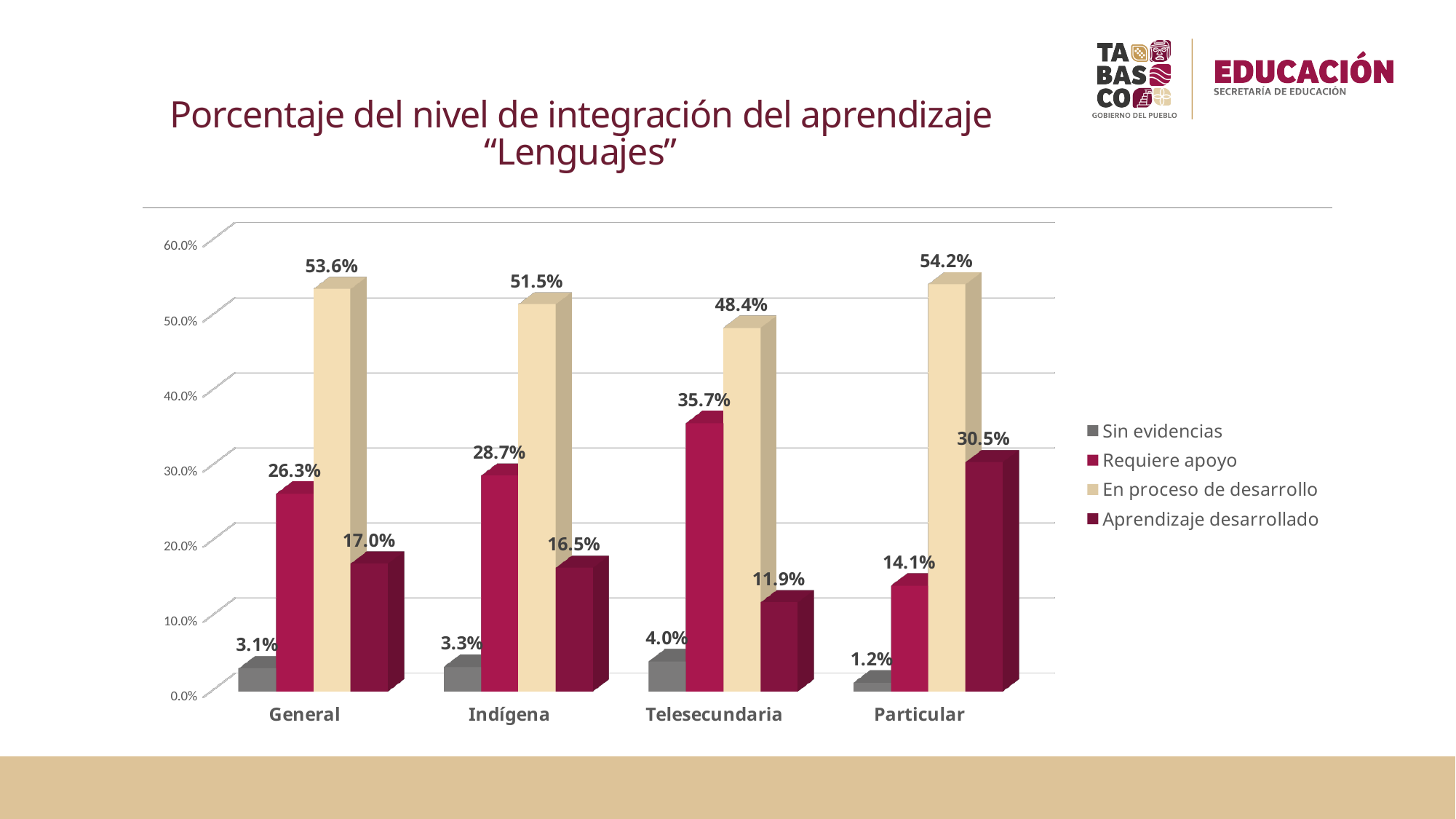
Which series is shown in the light beige colour? En proceso de desarrollo Which category has the lowest value for "En proceso de desarrollo"? Telesecundaria What is the value for "En proceso de desarrollo" in the General category? 53.6% What is the value for "Requiere apoyo" in the Telesecundaria category? 35.7% What is the difference between the "Requiere apoyo" values for Telesecundaria and Particular? 21.6% How many categories are shown on the x axis? 4 What is the value for "Sin evidencias" in the Particular category? 1.2% How many series does the legend list? 4 Which is larger: "Aprendizaje desarrollado" for General or for Indígena? General What kind of chart is shown on the slide? Bar chart Which category has the highest value for "Aprendizaje desarrollado"? Particular What is the total of the "Sin evidencias" and "Requiere apoyo" values for Indígena? 32.0%